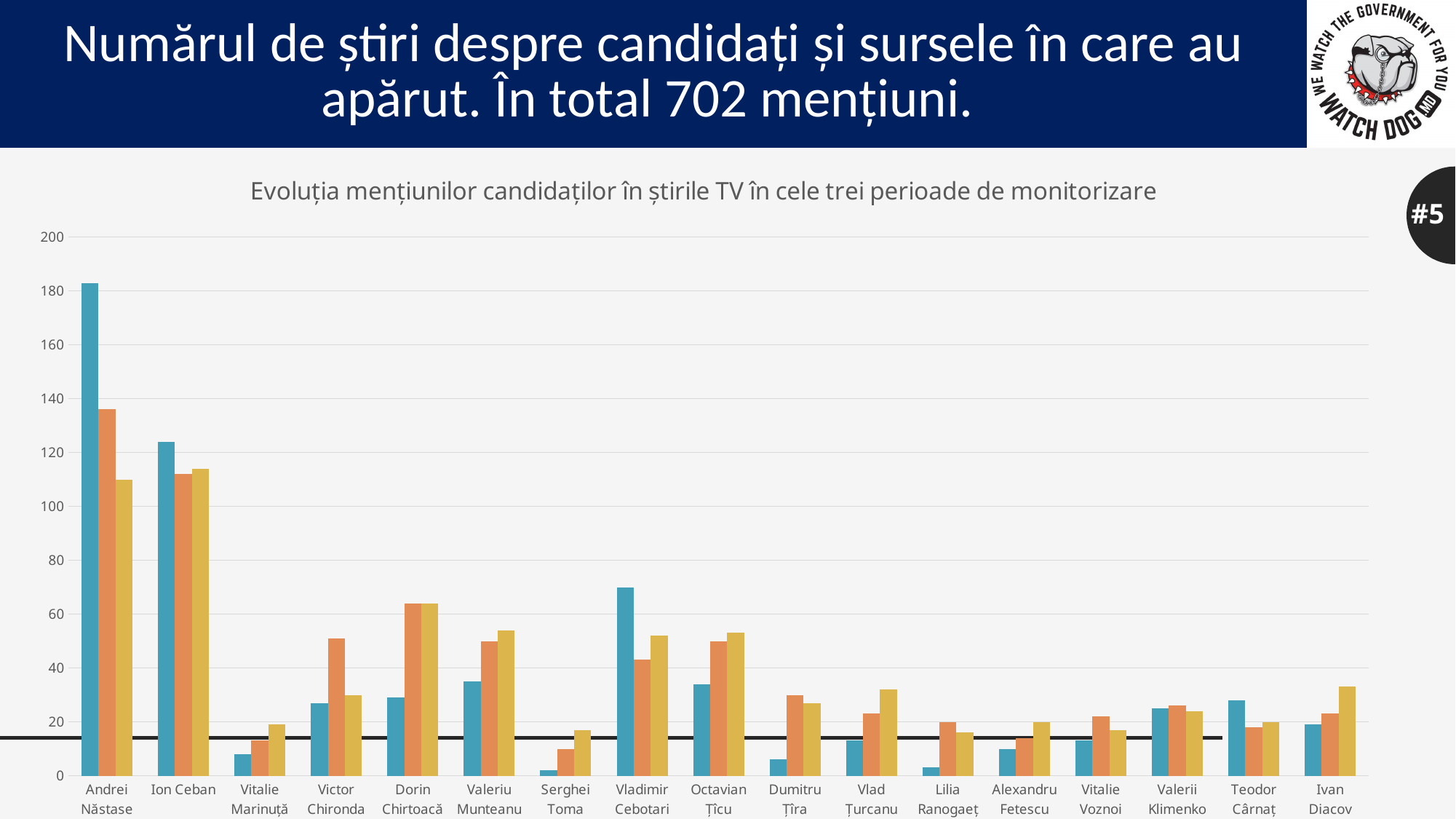
How many bars are plotted for each candidate? 3 How many candidates are shown on the x axis of the chart? 17 Is the first (blue) bar for Serghei Toma greater or less than 20? less Which candidate has the shortest bar in the chart? Serghei Toma Which is larger: the first (blue) bar for Andrei Năstase or the first (blue) bar for Ion Ceban? Andrei Năstase Is the tallest bar for Andrei Năstase greater or less than 160? greater Which candidate has the tallest bar in the chart? Andrei Năstase Is the second (orange) bar for Victor Chironda greater or less than 40? greater What is the title of the chart? Evoluția mențiunilor candidaților în știrile TV în cele trei perioade de monitorizare What kind of chart is shown on the slide? bar chart